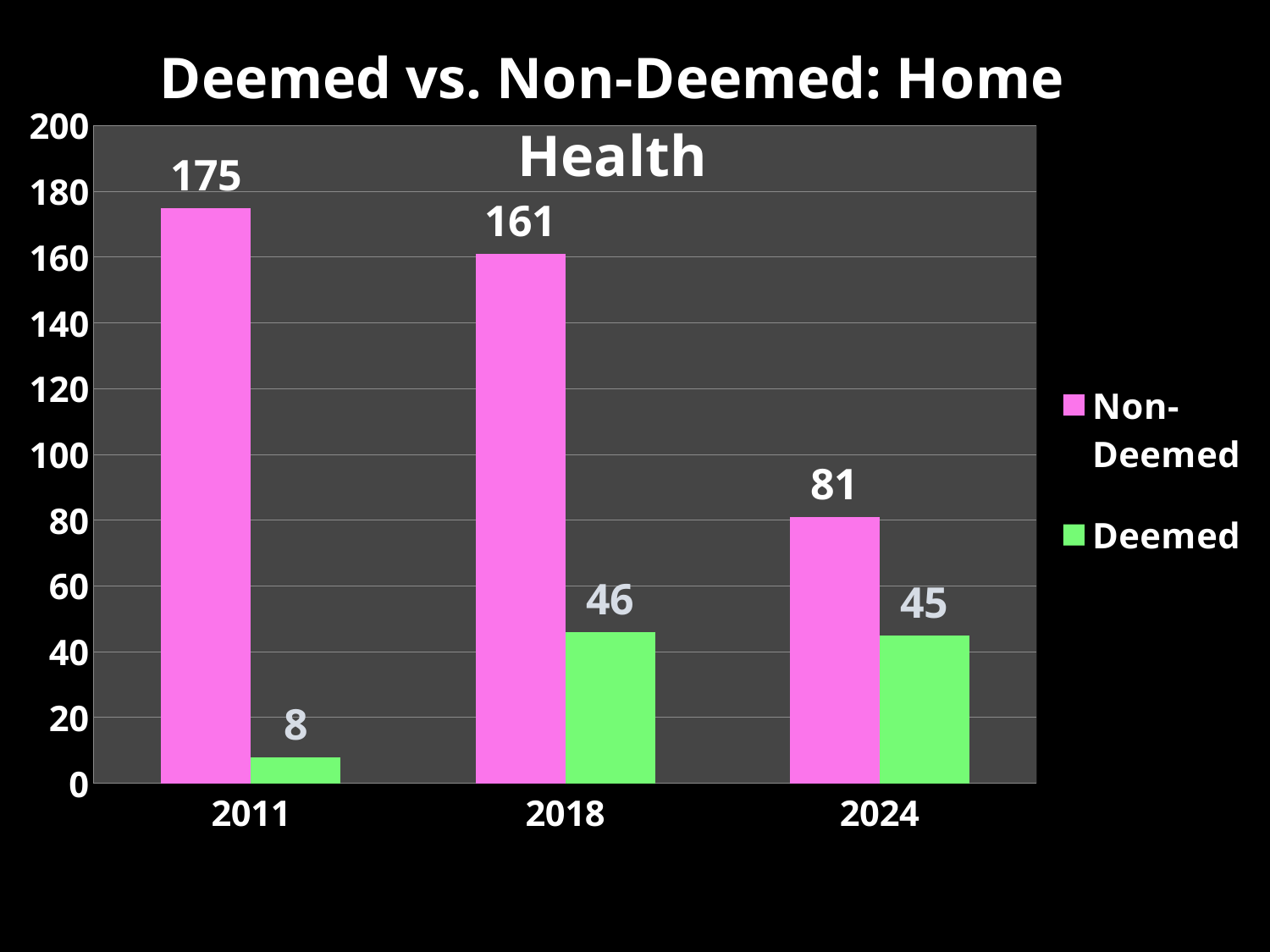
What is the Non-Deemed value for 2024? 81 How many series does the legend list? 2 Which is larger in 2018, the Non-Deemed value or the Deemed value? Non-Deemed How many years are shown on the x axis? 3 Which year has the highest Non-Deemed value? 2011 What is the Deemed value for 2018? 46 What is the Deemed value for 2011? 8 What is the difference between the Non-Deemed and Deemed values in 2024? 36 Which year has the lowest Deemed value? 2011 What is the Non-Deemed value for 2011? 175 Do the Non-Deemed values rise or fall from 2011 to 2024? Fall What kind of chart is shown on the slide? Bar chart